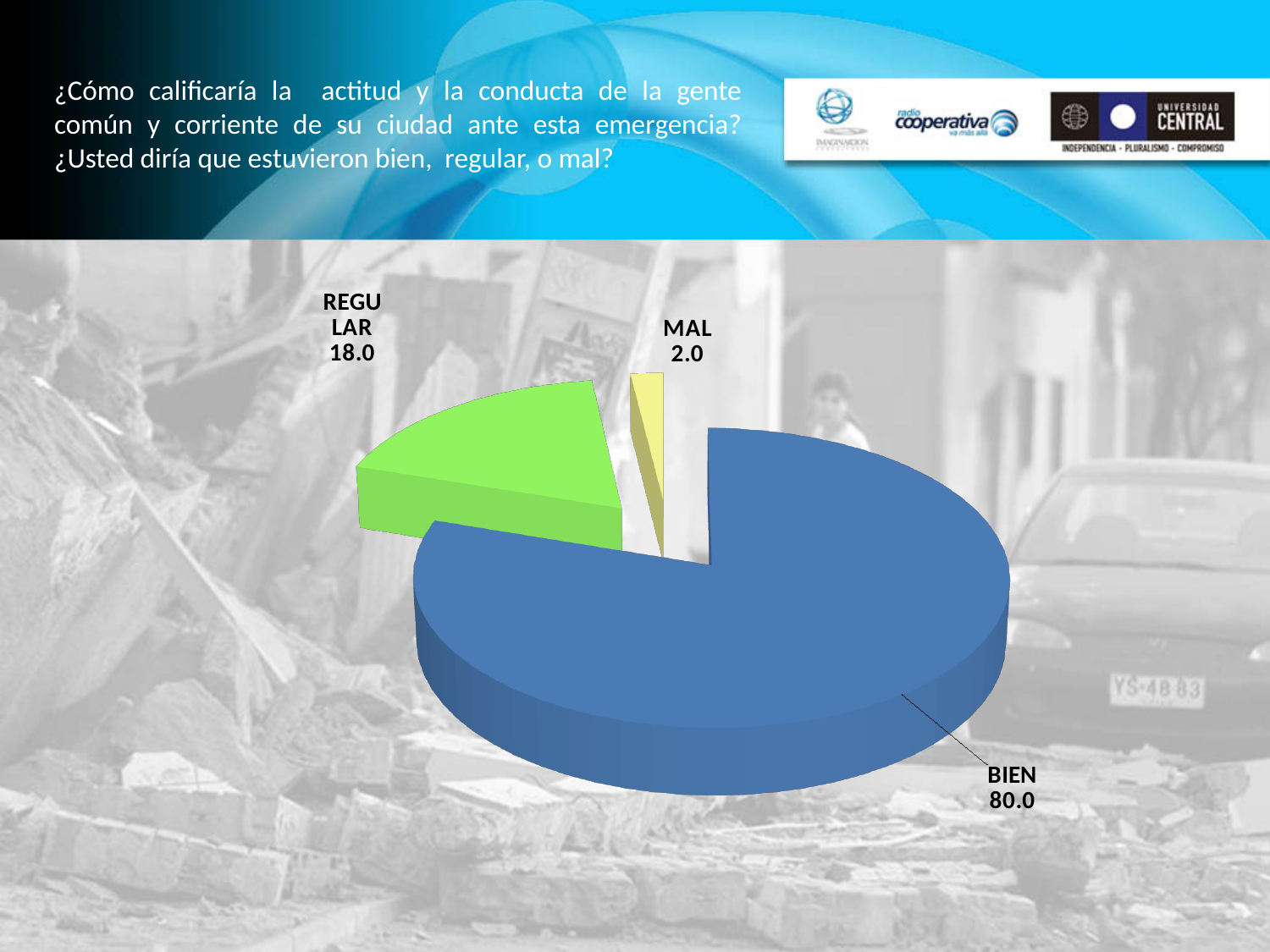
What is the difference between the values for BIEN and REGULAR? 62.0 Which category has the largest slice? BIEN What kind of chart is shown on the slide? pie chart What is the value for MAL? 2.0 What colour is the REGULAR slice? green How many slices does the pie chart have? 3 What is the difference between the values for REGULAR and MAL? 16.0 What is the value for BIEN? 80.0 Which is larger, the value for REGULAR or the value for MAL? REGULAR What colour is the BIEN slice? blue Which category has the smallest slice? MAL What is the value for REGULAR? 18.0